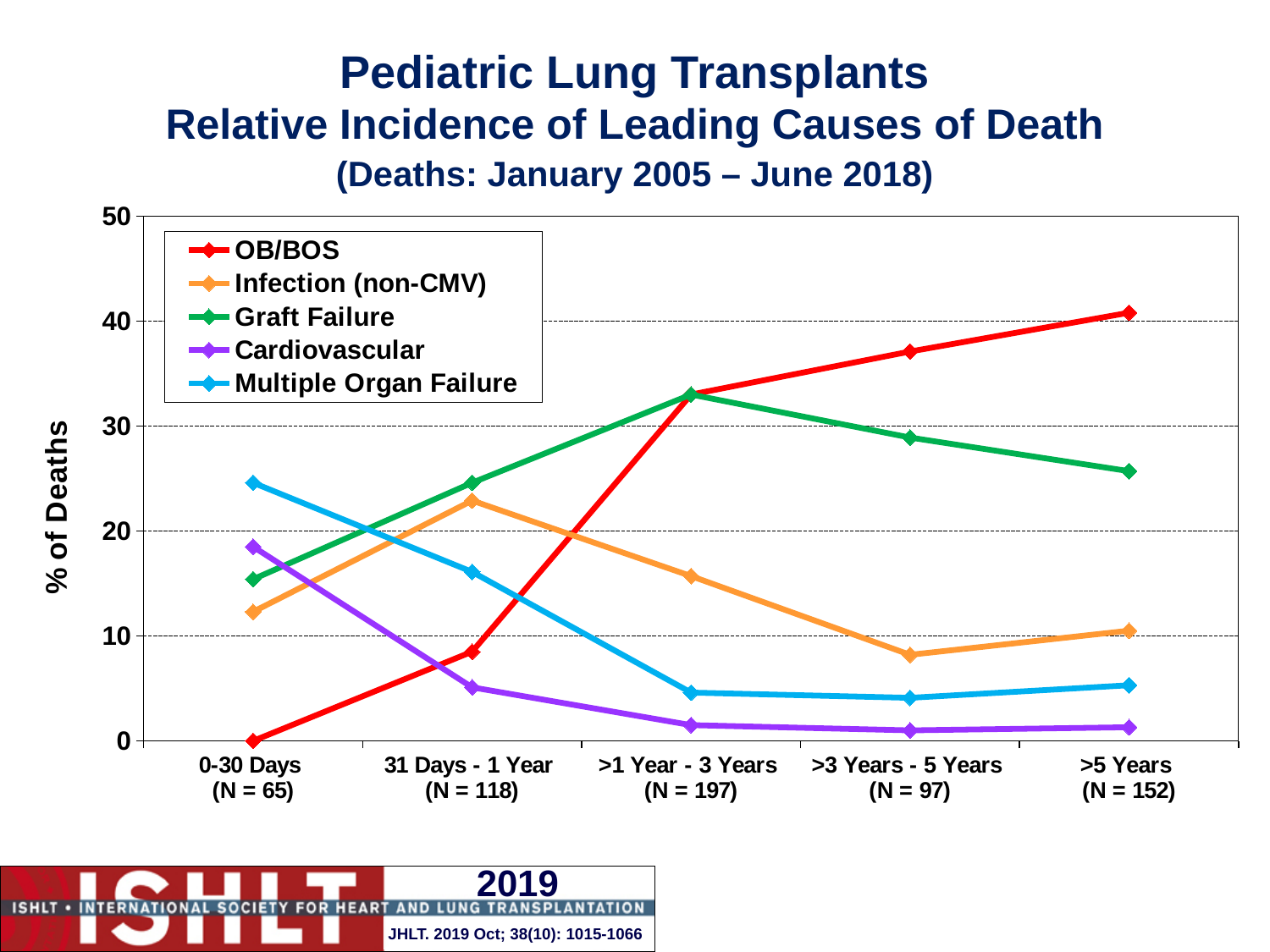
What colour is the line for Graft Failure in the legend? green Does the OB/BOS line rise or fall across the time periods from 0-30 Days to >5 Years? rises In the >3 Years - 5 Years period, which is larger: Graft Failure or Infection (non-CMV)? Graft Failure What kind of chart is shown on the slide? line chart Does the Cardiovascular line rise or fall from 0-30 Days to >1 Year - 3 Years? falls Is the value for Multiple Organ Failure at >3 Years - 5 Years greater or less than 10? less Which cause of death has the lowest % of Deaths in the 0-30 Days period? OB/BOS Which cause of death has the highest % of Deaths in the 0-30 Days period? Multiple Organ Failure How many series does the legend list? 5 Is the value for OB/BOS at >5 Years greater or less than 40? greater How many time-period categories are shown on the x axis? 5 Which cause of death has the highest % of Deaths in the >5 Years period? OB/BOS